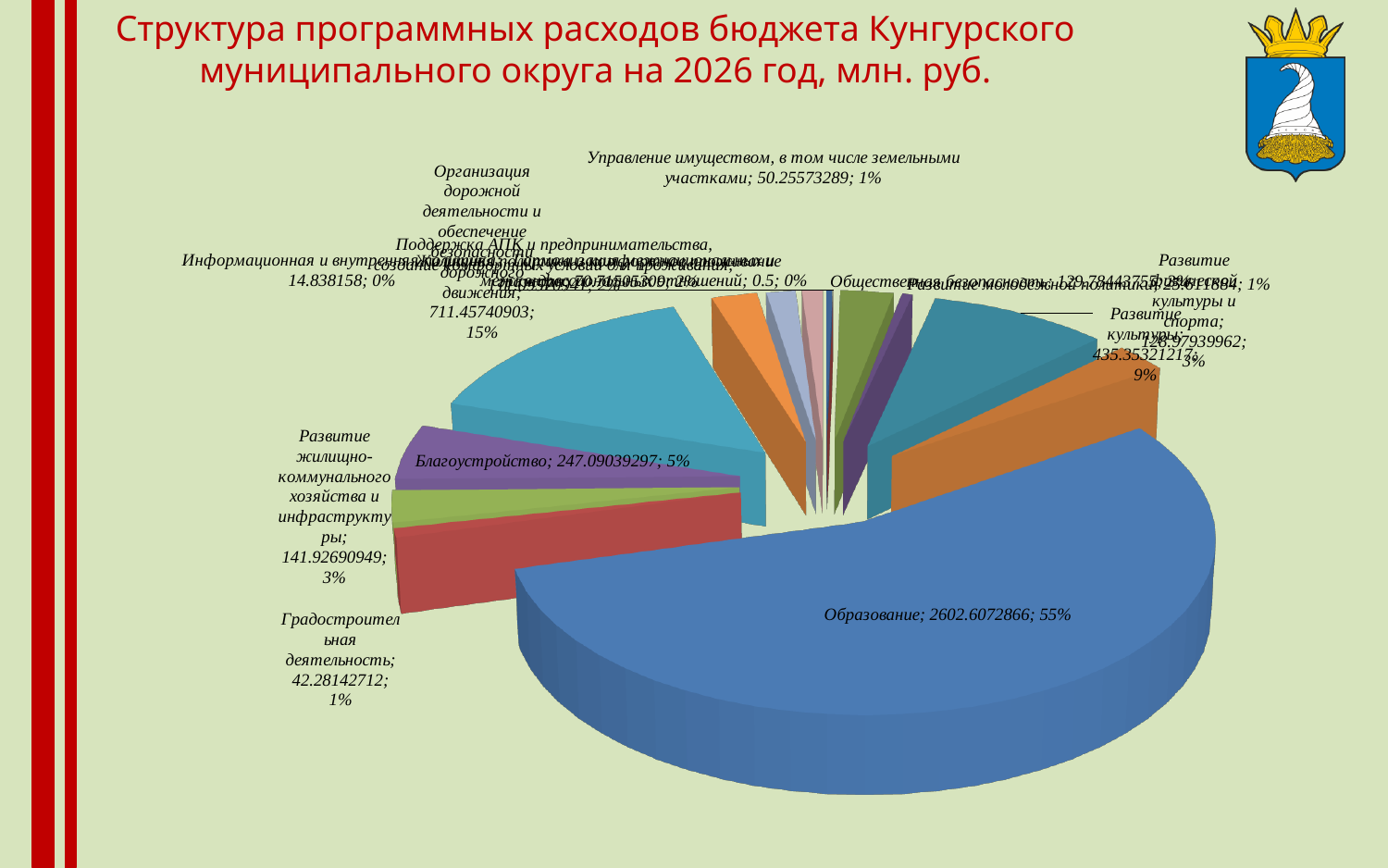
What is the value shown for Благоустройство? 247.09039297 What is the title of the chart? Структура программных расходов бюджета Кунгурского муниципального округа на 2026 год, млн. руб. What share of the pie does Развитие культуры represent? 9% What is the difference between the values for Благоустройство and Развитие жилищно-коммунального хозяйства и инфраструктуры? 105.16348348 What type of chart is shown on the slide? pie chart Which category has the largest slice of the pie? Образование What is the value shown for Образование? 2602.6072866 Which is larger: Благоустройство or Развитие жилищно-коммунального хозяйства и инфраструктуры? Благоустройство What is the value shown for Управление имуществом, в том числе земельными участками? 50.25573289 What is the value shown for Градостроительная деятельность? 42.28142712 What share of the pie does Образование represent? 55% What share of the pie does Организация дорожной деятельности и обеспечение безопасности дорожного движения represent? 15%